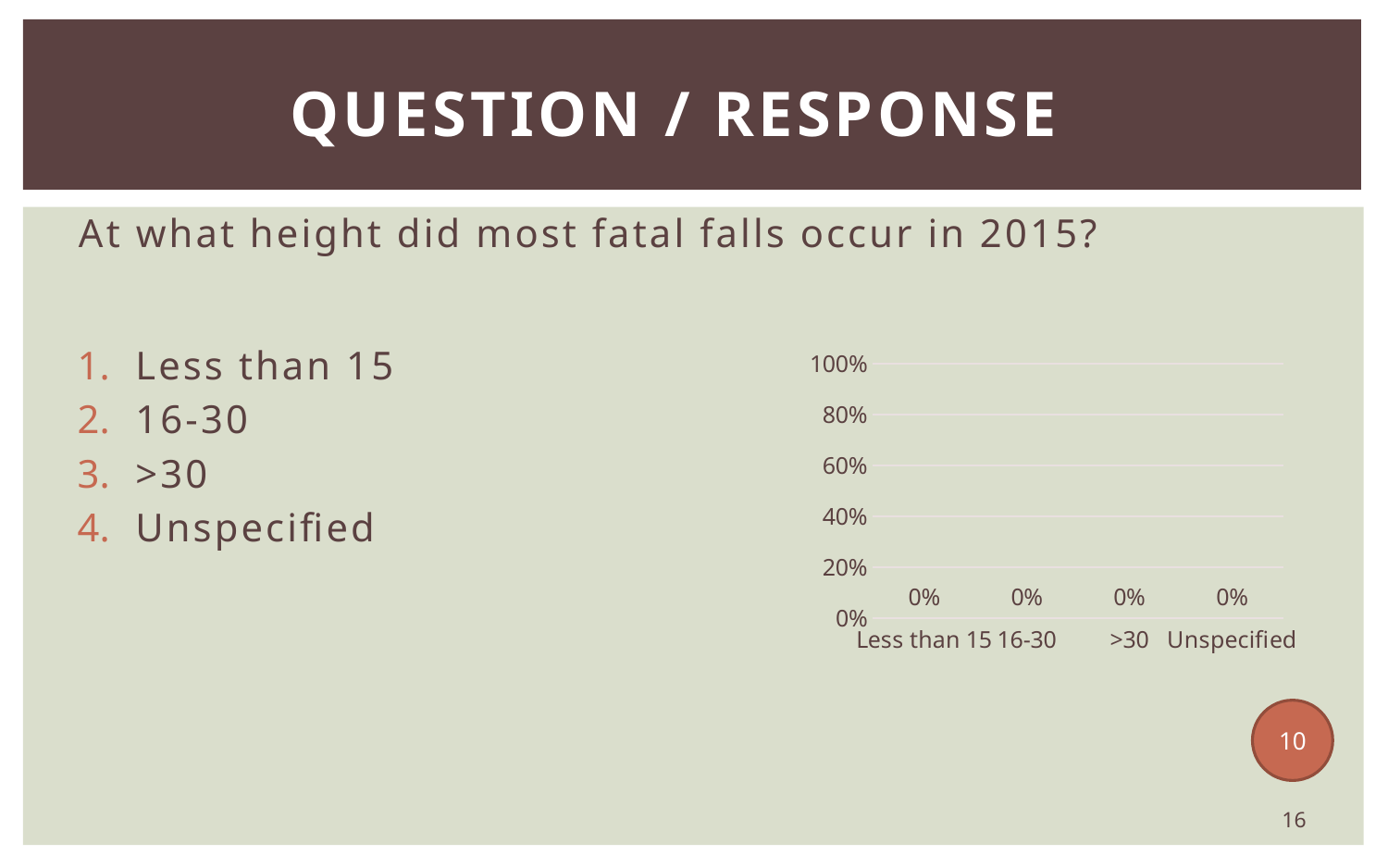
What is the value for "Less than 15" in the chart? 0% Is the value for "Less than 15" greater or less than 40%? less What is the value for "Unspecified" in the chart? 0% Is the value for "Unspecified" greater or less than 20%? less What is the value for "16-30" in the chart? 0% What is the label of the first category on the x axis of the chart? Less than 15 What is the value for ">30" in the chart? 0% How many categories are shown on the x axis of the chart? 4 What is the highest value shown on the chart's y axis? 100% What is the difference between the values for "16-30" and ">30"? 0%